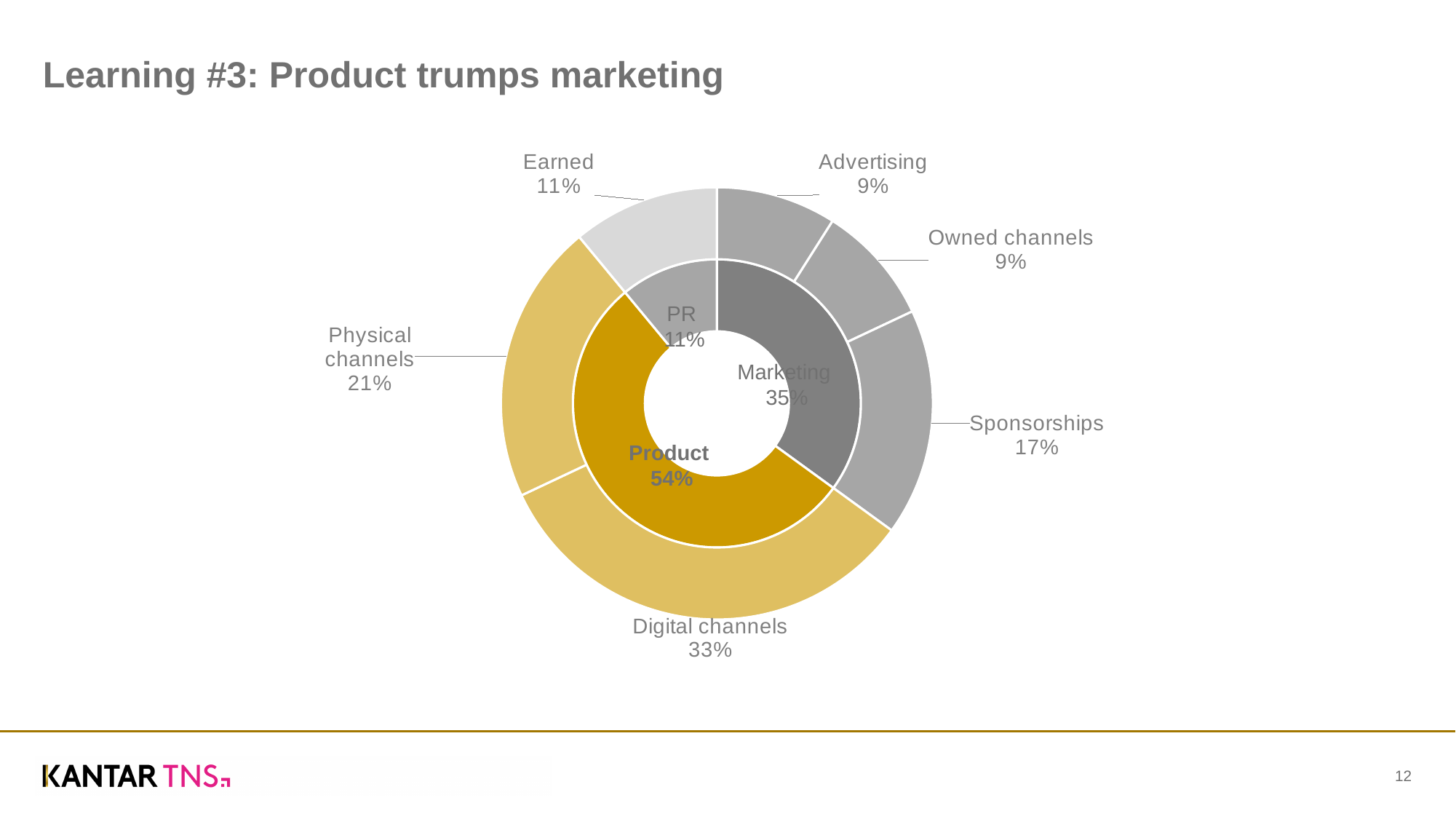
What kind of chart is shown on the slide? Doughnut chart Which is larger in the outer ring, Physical channels or Sponsorships? Physical channels What is the value for Marketing in the inner ring? 35% What is the combined share of Digital channels and Physical channels in the outer ring? 54% What is the difference between the Product and Marketing shares in the inner ring? 19% Which segment of the inner ring has the smallest share? PR What is the title of the slide? Learning #3: Product trumps marketing What is the value for Product in the inner ring? 54% What is the value for Digital channels in the outer ring? 33% Which segment of the outer ring has the largest share? Digital channels What is the value for Sponsorships in the outer ring? 17% How many segments are in the outer ring? 6